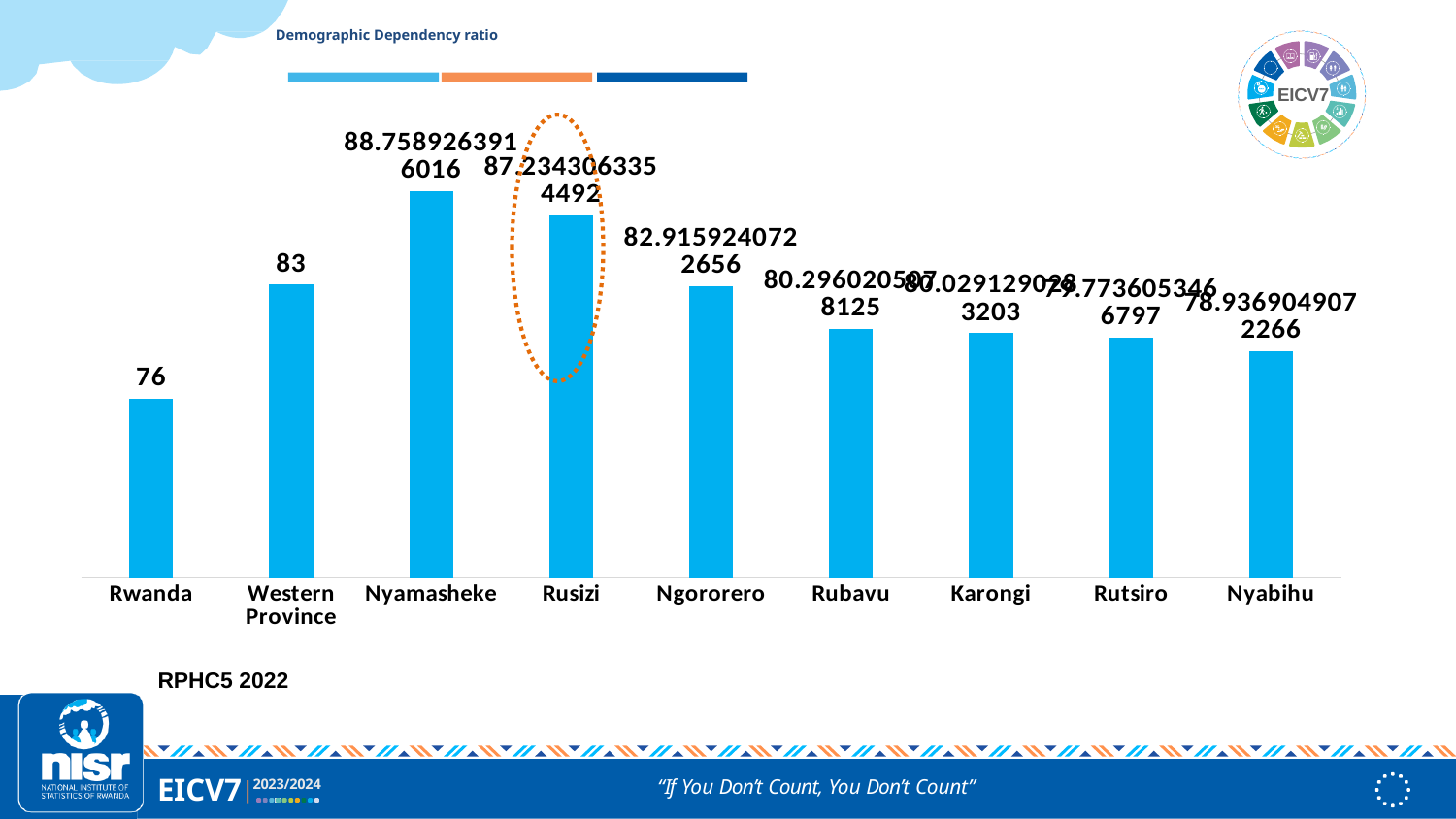
What is the demographic dependency ratio for Western Province? 83 How many categories are shown on the x axis of the chart? 9 What kind of chart is shown on the slide? Bar chart Which category has the highest demographic dependency ratio? Nyamasheke Which has a higher demographic dependency ratio, Rusizi or Ngororero? Rusizi What value is labelled on the bar for Nyamasheke? 88.7589263916016 What value is labelled on the bar for Rusizi? 87.2343063354492 What is the difference between the values for Western Province and Rwanda? 7 Do the values rise or fall from Nyamasheke to Nyabihu along the x axis? Fall What is the demographic dependency ratio for Rwanda? 76 Which category has the lowest demographic dependency ratio? Rwanda Which category's bar is highlighted with a dashed orange circle? Rusizi